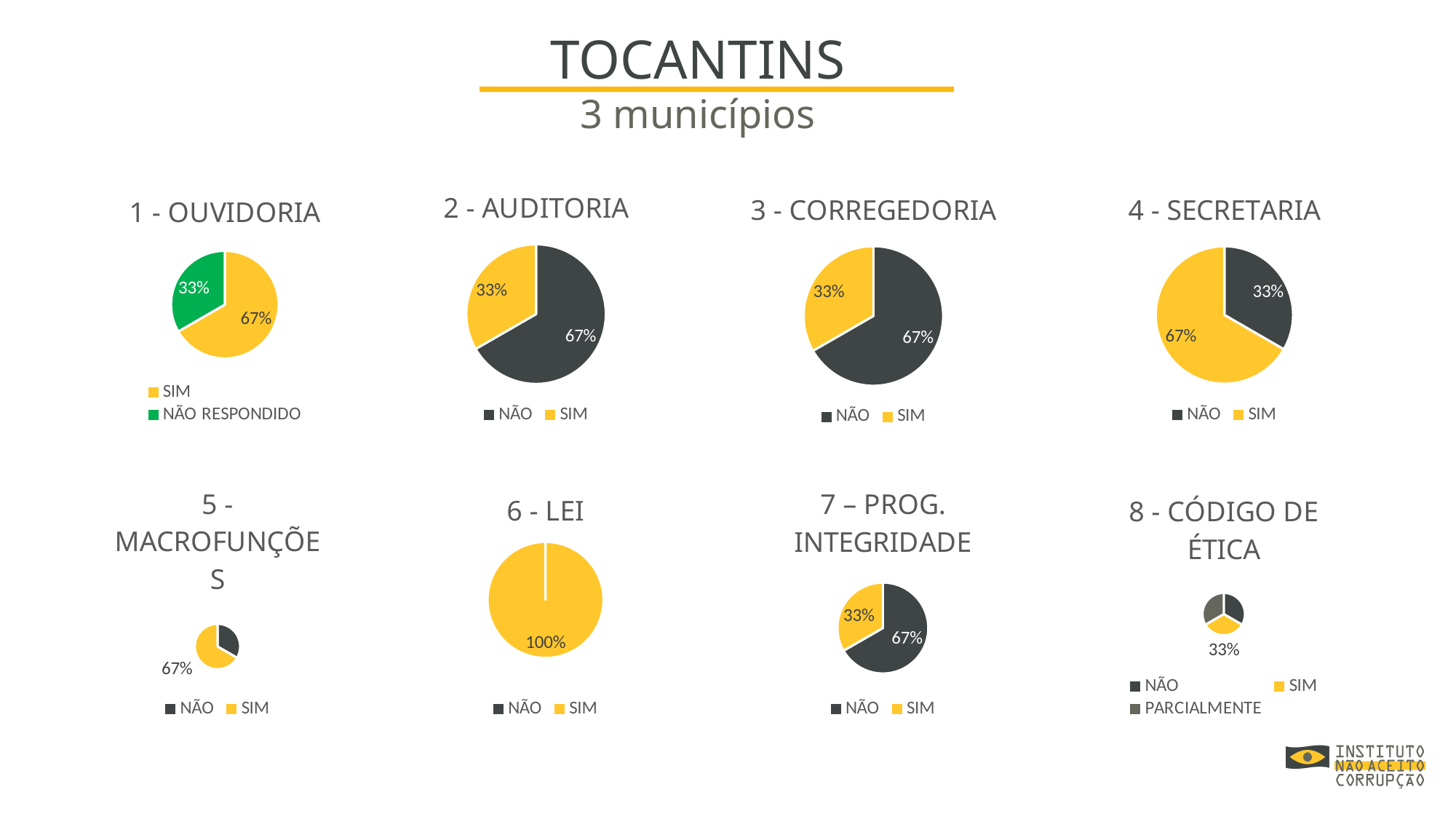
What kind of chart is '5 - MACROFUNÇÕES'? Pie chart In the '3 - CORREGEDORIA' chart, what share is labelled for SIM? 33% How many entries does the legend of the '8 - CÓDIGO DE ÉTICA' chart list? 3 In the '1 - OUVIDORIA' chart, what share is labelled for SIM? 67% In the '6 - LEI' chart, what share is labelled for SIM? 100% In the '8 - CÓDIGO DE ÉTICA' chart, what share is labelled for SIM? 33% In the '7 – PROG. INTEGRIDADE' chart, which category has the largest slice? NÃO How many pie charts are shown on the slide? 8 In the '1 - OUVIDORIA' chart, what share is labelled for NÃO RESPONDIDO? 33% In the '1 - OUVIDORIA' chart, what colour is the NÃO RESPONDIDO slice? Green In the '2 - AUDITORIA' chart, what share is labelled for NÃO? 67% In the '4 - SECRETARIA' chart, which slice is larger, NÃO or SIM? SIM